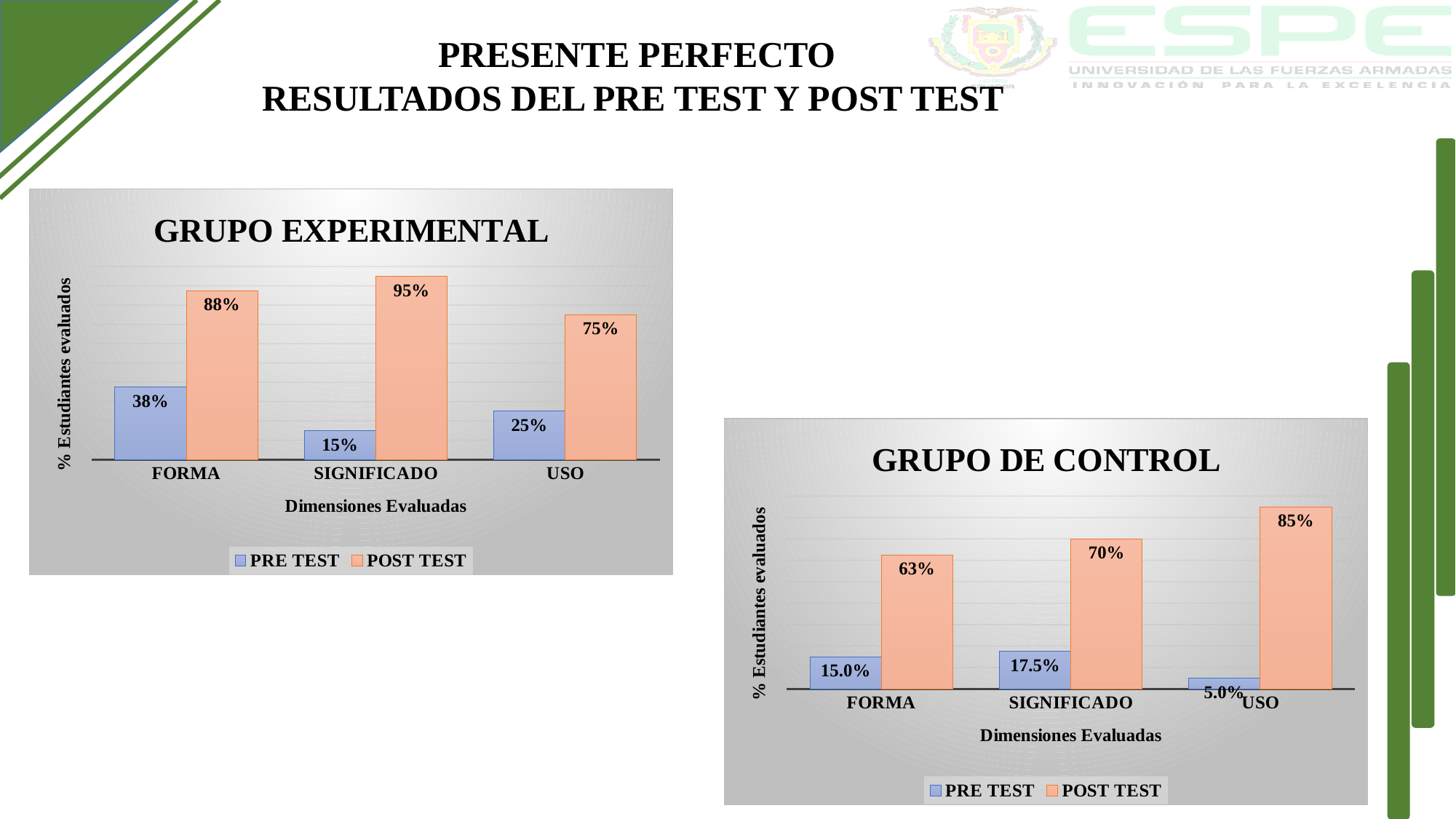
In the GRUPO DE CONTROL chart, what is the PRE TEST value for SIGNIFICADO? 17.5% In the GRUPO DE CONTROL chart, which is larger: the PRE TEST value for FORMA or the PRE TEST value for USO? FORMA What type of chart is the GRUPO EXPERIMENTAL chart? Bar chart In the GRUPO DE CONTROL chart, what is the difference between the POST TEST and PRE TEST values for FORMA? 48% In the GRUPO EXPERIMENTAL chart, which dimension has the lowest PRE TEST value? SIGNIFICADO In the GRUPO DE CONTROL chart, what is the POST TEST value for USO? 85% In the GRUPO EXPERIMENTAL chart, what is the POST TEST value for SIGNIFICADO? 95% In the GRUPO DE CONTROL chart, which dimension has the highest POST TEST value? USO How many series does the legend of the GRUPO DE CONTROL chart list? 2 How many dimensions are shown on the x axis of the GRUPO EXPERIMENTAL chart? 3 In the GRUPO EXPERIMENTAL chart, what is the PRE TEST value for FORMA? 38% In the GRUPO EXPERIMENTAL chart, what is the difference between the POST TEST and PRE TEST values for USO? 50%